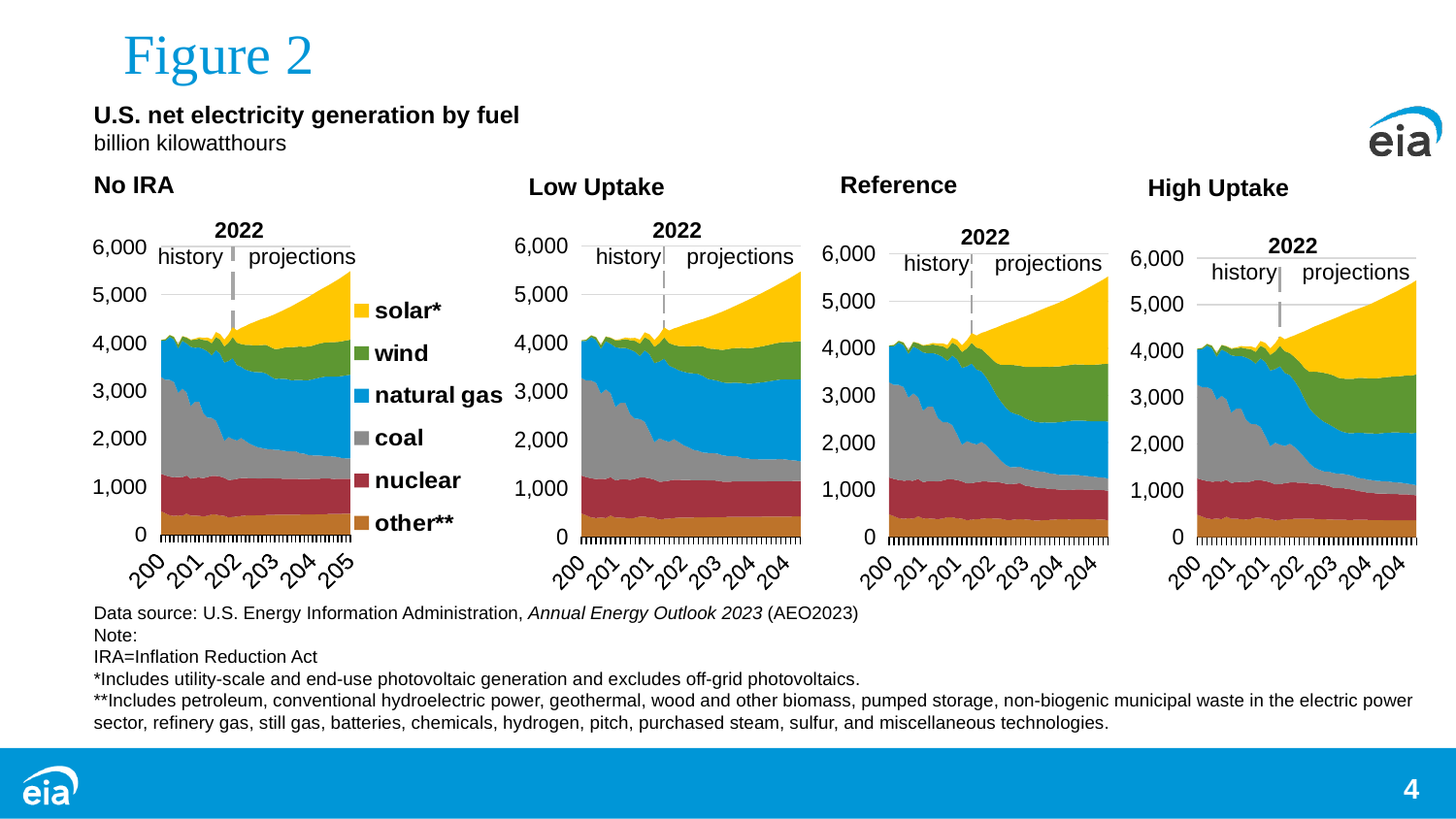
What unit is the y axis of the charts measured in? billion kilowatthours How many series does the legend list for the charts? 6 In the Low Uptake chart, does the solar* area rise or fall over the projection period? rise Which colour represents solar* in the legend? yellow In the Reference chart, is the total net electricity generation at the start of the history period greater or less than 5,000? less What kind of chart is used in each of the four panels on the slide? stacked area chart In the High Uptake chart, does total net electricity generation rise or fall over the projection period? rise In the High Uptake chart, is the total net electricity generation at the end of the projection period greater or less than 5,000? greater What year does the dashed vertical line separating history from projections mark in each chart? 2022 In the Reference chart, does the coal area rise or fall over the history period? fall In the No IRA chart, is the total net electricity generation at the end of the projection period greater or less than 5,000? greater How many charts (scenario panels) are shown on the slide? 4